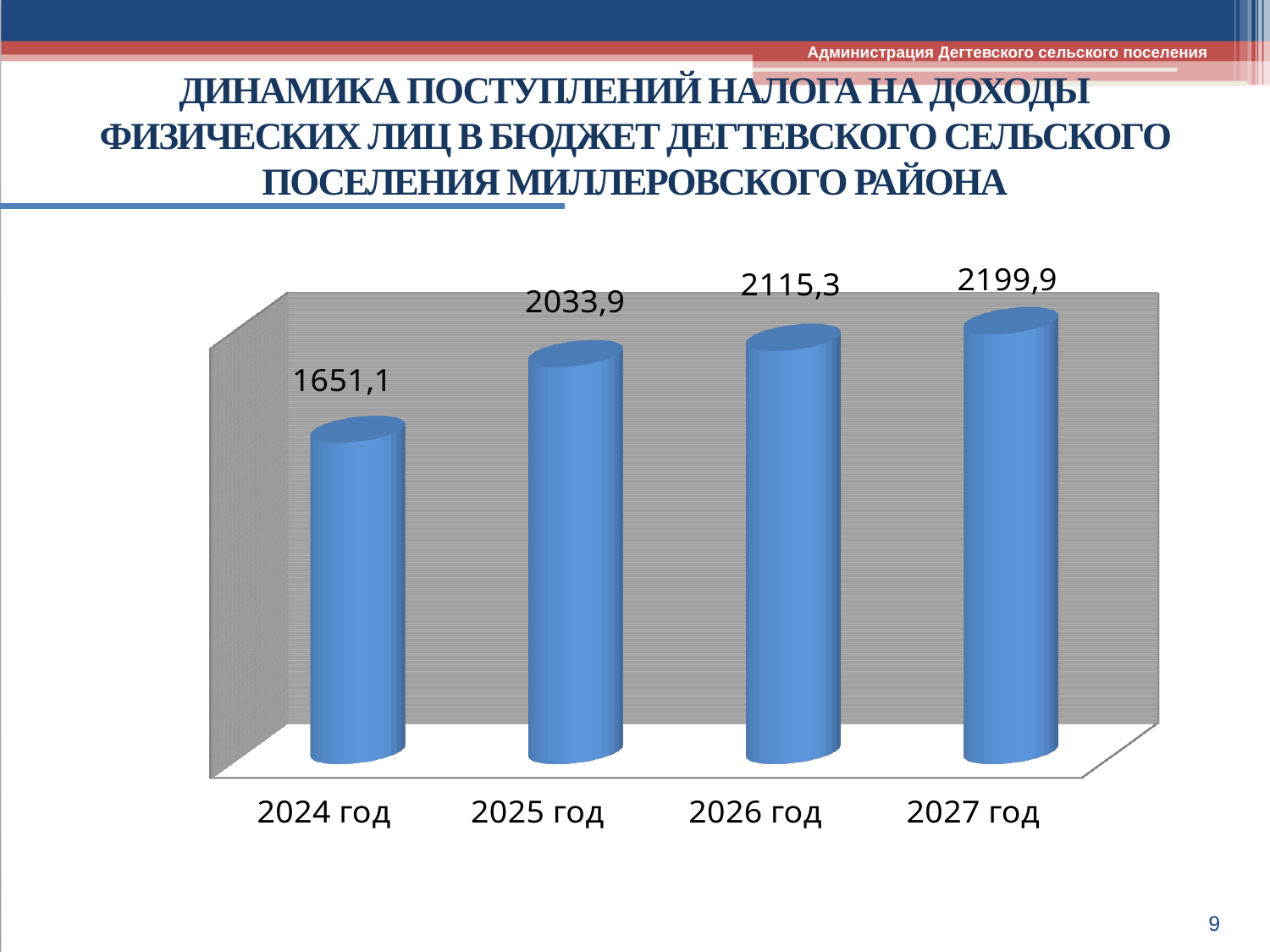
What is the value for 2027 год? 2199,9 Which is larger, the value for 2026 год or the value for 2027 год? 2027 год What is the difference between the values for 2027 год and 2026 год? 84,6 Do the values rise or fall from 2024 год to 2027 год? Rise What is the value for 2026 год? 2115,3 Which year has the lowest value? 2024 год What is the difference between the values for 2025 год and 2024 год? 382,8 How many years are shown on the chart? 4 What is the value for 2024 год? 1651,1 What kind of chart is shown on the slide? Bar chart Which year has the highest value? 2027 год What is the value for 2025 год? 2033,9